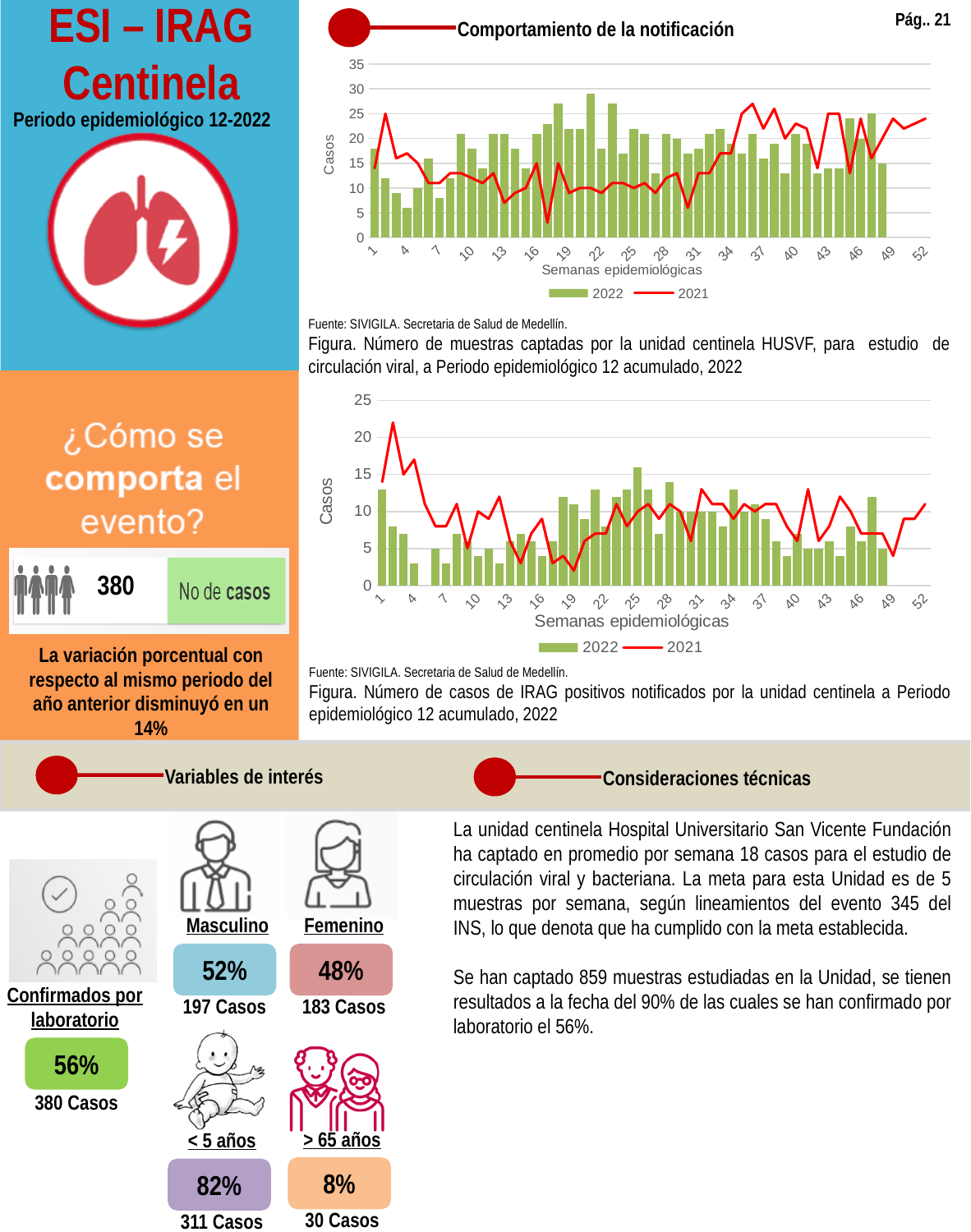
In the top chart (muestras captadas), which 2022 bar is larger, week 21 or week 4? Week 21 In the top chart (Comportamiento de la notificación, muestras captadas), what kind of chart is used? A bar chart combined with a line chart In the top chart (muestras captadas), is the 2022 bar for week 4 greater or less than 10? less In the bottom chart (casos de IRAG positivos), which 2022 bar is larger, week 1 or week 4? Week 1 In the top chart (muestras captadas), which year is shown as a red line? 2021 In the top chart (muestras captadas), which year is shown as bars? 2022 In the bottom chart (casos de IRAG positivos), how many series does the legend list? 2 In the bottom chart (casos de IRAG positivos), is the 2022 bar for week 1 greater or less than 10? greater In the top chart (muestras captadas), how many series does the legend list? 2 In the bottom chart (casos de IRAG positivos), what is the highest value shown on the y axis? 25 In the bottom chart (casos de IRAG positivos), is the 2022 bar for week 4 greater or less than 5? less